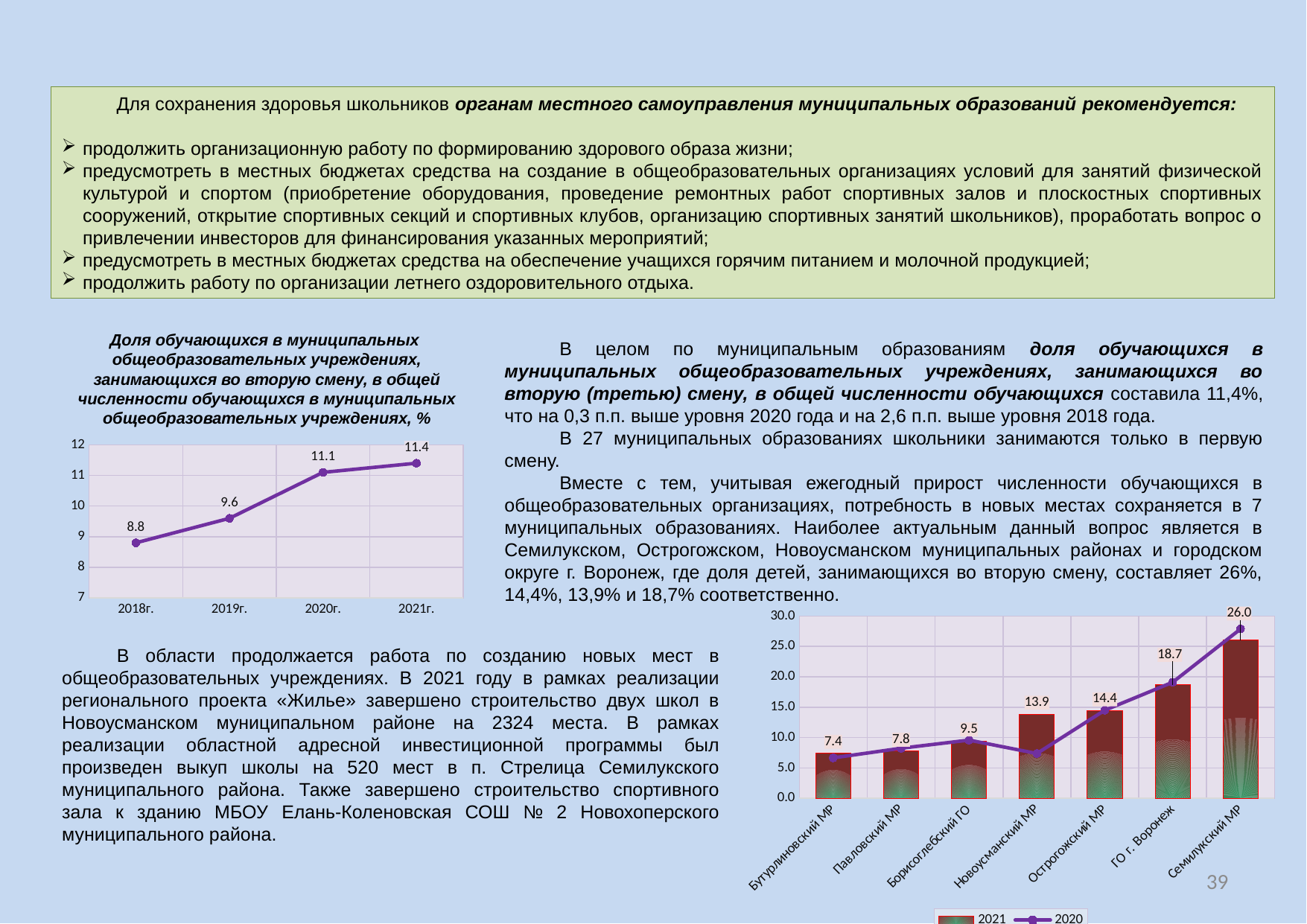
In the bar chart on the right, how many series does the legend list? 2 In the line chart on the left, what is the value for 2018г.? 8.8 In the line chart on the left, do the values rise or fall from 2018г. to 2021г.? rise In the line chart on the left, by how much did the value increase from 2019г. to 2020г.? 1.5 In the bar chart on the right, which municipality has the lowest 2021 value? Бутурлиновский МР In the bar chart on the right, what is the 2021 value for Семилукский МР? 26.0 In the line chart on the left, what is the value for 2021г.? 11.4 In the line chart on the left, which year has the lowest value? 2018г. In the bar chart on the right, what is the 2021 value for Новоусманский МР? 13.9 In the bar chart on the right, is the 2020 value for Семилукский МР greater or less than 25.0? greater In the bar chart on the right, what is the difference between the 2021 values for ГО г. Воронеж and Острогожский МР? 4.3 In the line chart on the left, how many years are plotted? 4